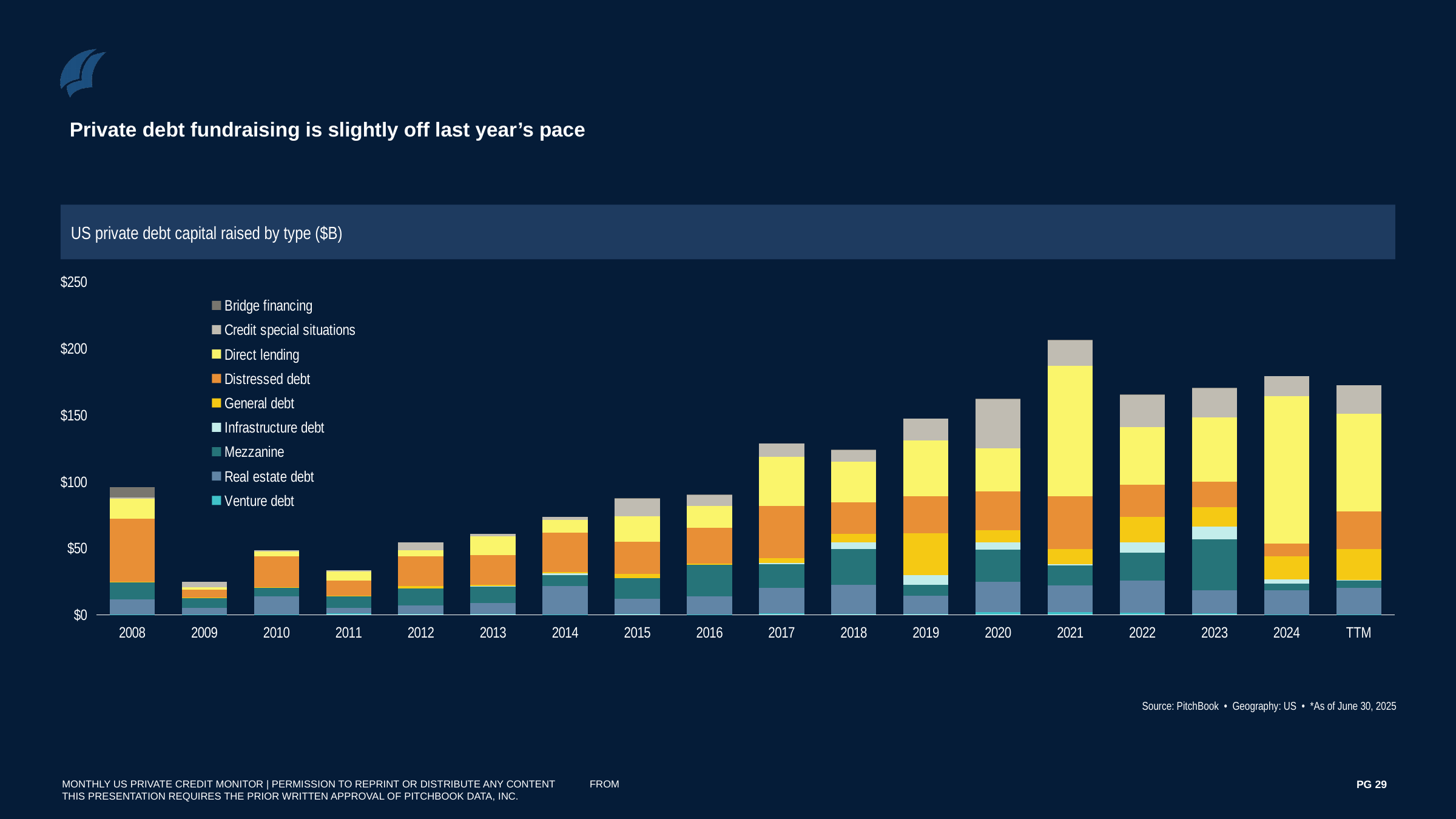
Is the total value for 2009 greater or less than $50? less What kind of chart is shown on the slide? Stacked bar chart What is the title of the chart? US private debt capital raised by type ($B) Is the total value for 2024 greater or less than $150? greater Which has a larger total, 2021 or 2022? 2021 Is the total value for 2021 greater or less than $150? greater Which year has the highest total private debt capital raised? 2021 Which year has the lowest total private debt capital raised? 2009 How many series does the legend list? 9 How many categories are shown along the x axis? 18 Do the total bar heights generally rise or fall from 2009 to 2021? Rise